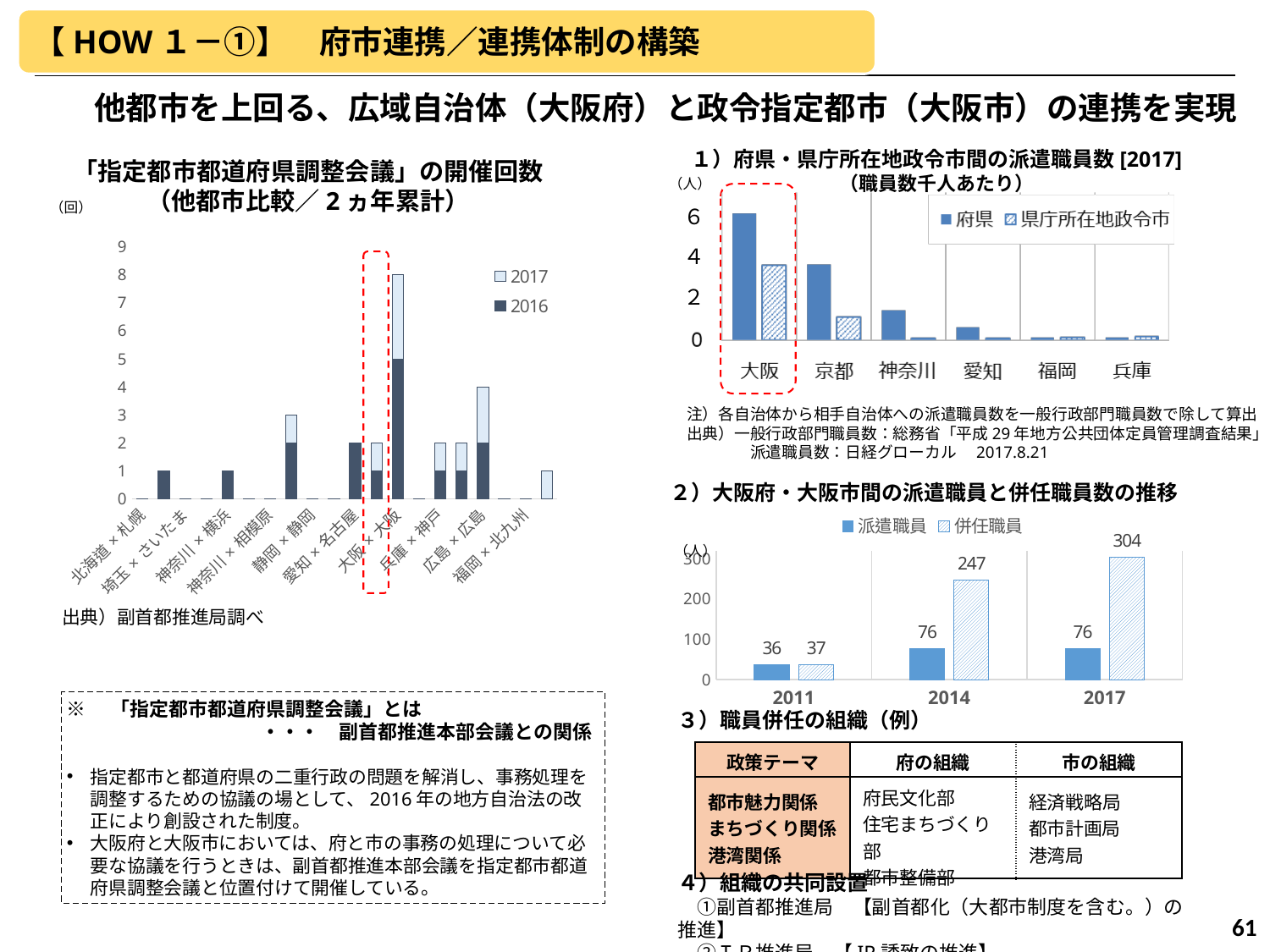
In the chart titled 「指定都市都道府県調整会議」の開催回数, is the total for 大阪×大阪 greater or less than 5? greater In the chart titled 府県・県庁所在地政令市間の派遣職員数 [2017], is the 県庁所在地政令市 value for 京都 greater or less than 2? less In the chart titled 大阪府・大阪市間の派遣職員と併任職員数の推移, what is the 派遣職員 value for 2011? 36 In the chart titled 府県・県庁所在地政令市間の派遣職員数 [2017], how many prefectures are shown on the x axis? 6 In the chart titled 大阪府・大阪市間の派遣職員と併任職員数の推移, what is the difference between the 併任職員 values for 2017 and 2014? 57 In the chart titled 大阪府・大阪市間の派遣職員と併任職員数の推移, does the 併任職員 value rise or fall from 2011 to 2017? rise In the chart titled 府県・県庁所在地政令市間の派遣職員数 [2017], which prefecture has the highest 府県 value? 大阪 In the chart titled 「指定都市都道府県調整会議」の開催回数, how many series does the legend list? 2 What kind of chart is the one titled 大阪府・大阪市間の派遣職員と併任職員数の推移? bar chart In the chart titled 「指定都市都道府県調整会議」の開催回数, which pairing has the highest total number of meetings? 大阪×大阪 In the chart titled 府県・県庁所在地政令市間の派遣職員数 [2017], is the 府県 value for 大阪 greater or less than 4? greater In the chart titled 大阪府・大阪市間の派遣職員と併任職員数の推移, what is the 併任職員 value for 2017? 304